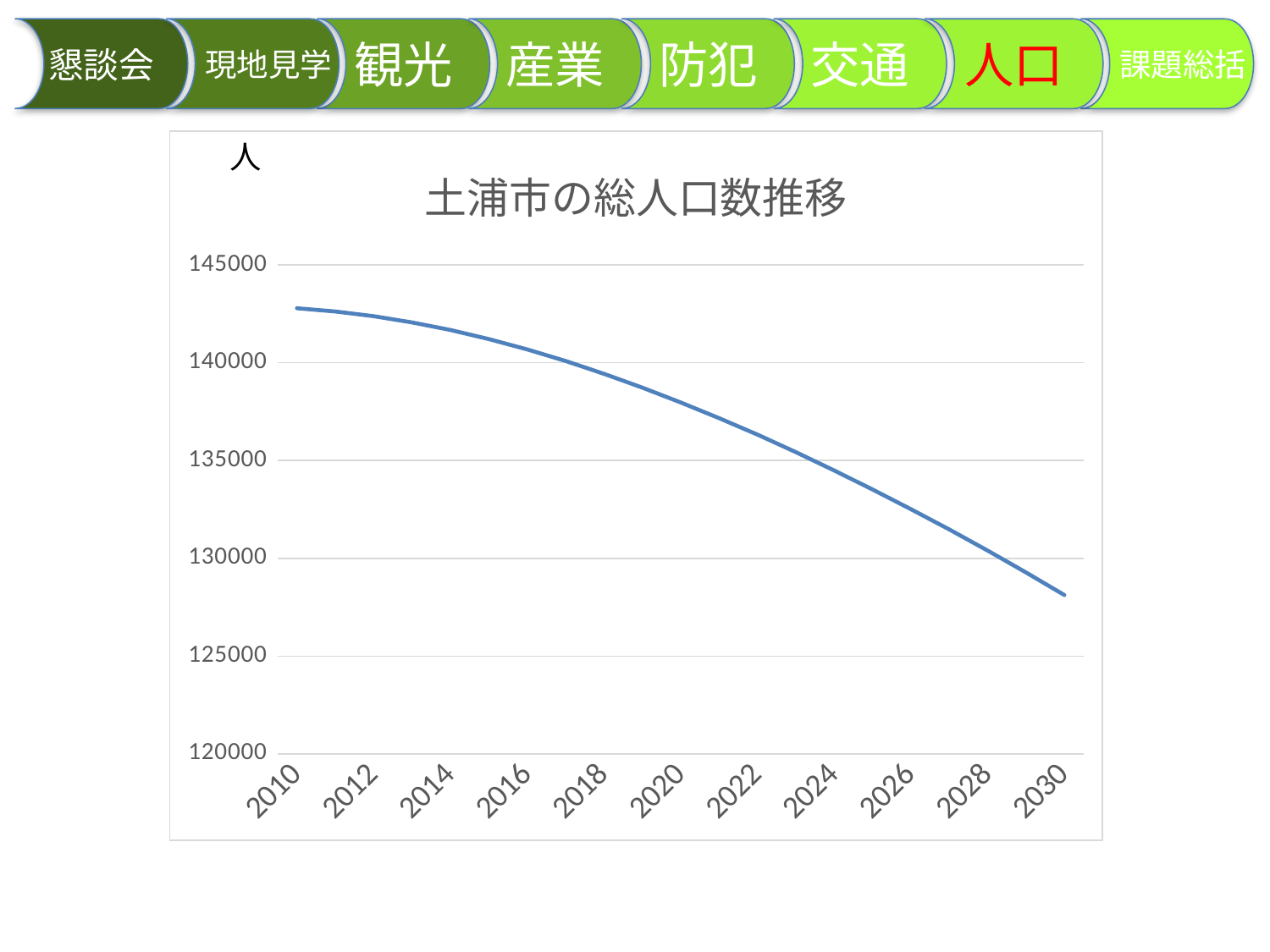
Is the value for 2030 greater or less than 130000? less Is the value for 2020 greater or less than 135000? greater Is the value for 2022 greater or less than 140000? less What kind of chart is shown on the slide? line chart Which is larger, the value for 2010 or the value for 2030? 2010 Which year has the lowest value on the chart? 2030 How many year labels are shown on the x axis? 11 What is the title of the chart? 土浦市の総人口数推移 Which year has the highest value on the chart? 2010 Do the values rise or fall from 2010 to 2030? fall